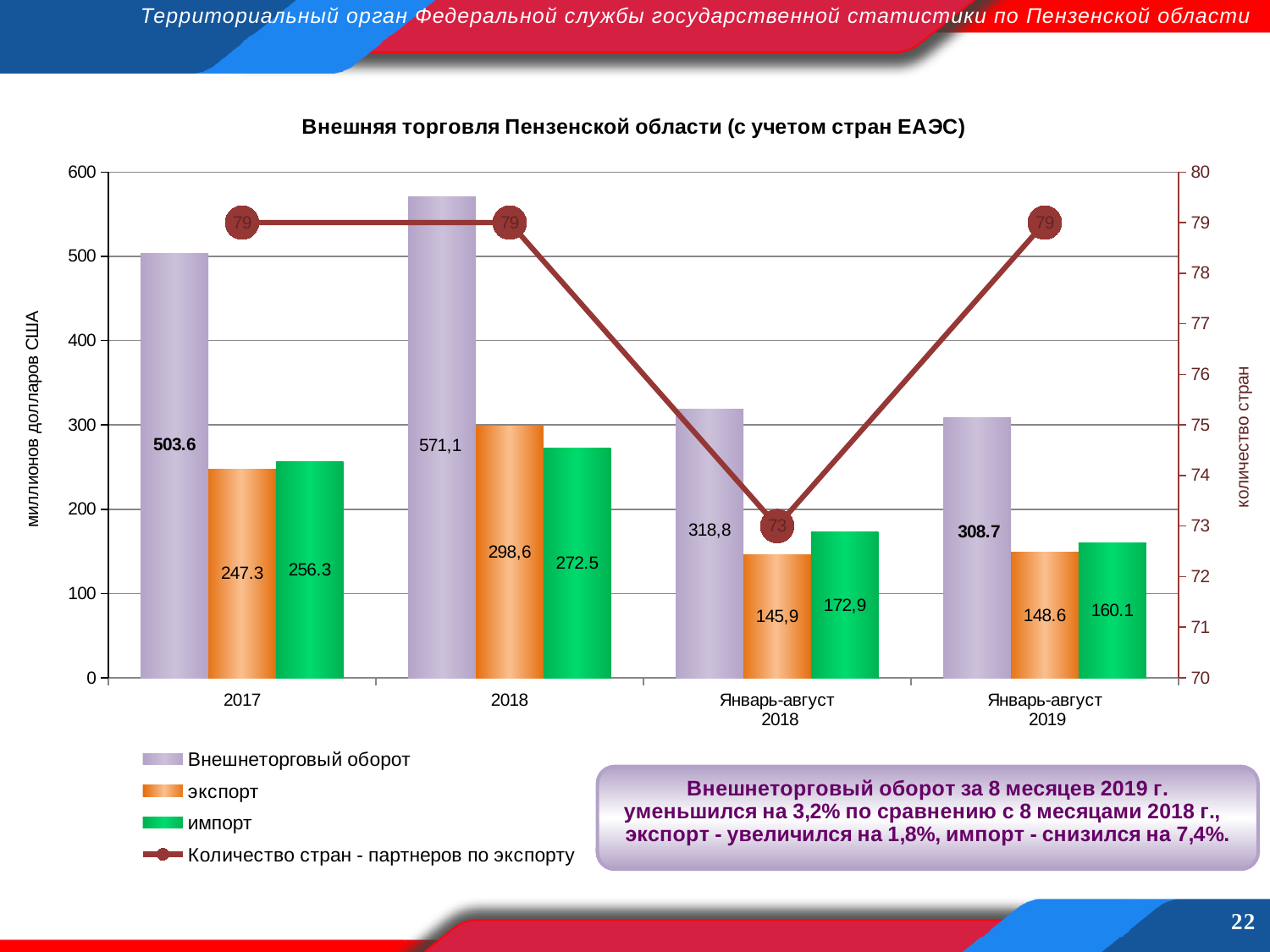
What is the value of импорт for 2017? 256.3 What is the difference between импорт for Январь-август 2018 and Январь-август 2019? 12,8 What is the value of Количество стран - партнеров по экспорту for Январь-август 2018? 73 What is the value of экспорт for Январь-август 2019? 148.6 In which category is Внешнеторговый оборот the highest? 2018 Which is larger for 2018: экспорт or импорт? экспорт In which category is экспорт the lowest? Январь-август 2018 How many categories are shown on the x axis? 4 What kind of chart is this? Combined bar and line chart What is the title of the chart? Внешняя торговля Пензенской области (с учетом стран ЕАЭС) What is the value of Внешнеторговый оборот for 2018? 571,1 How many series does the legend list? 4